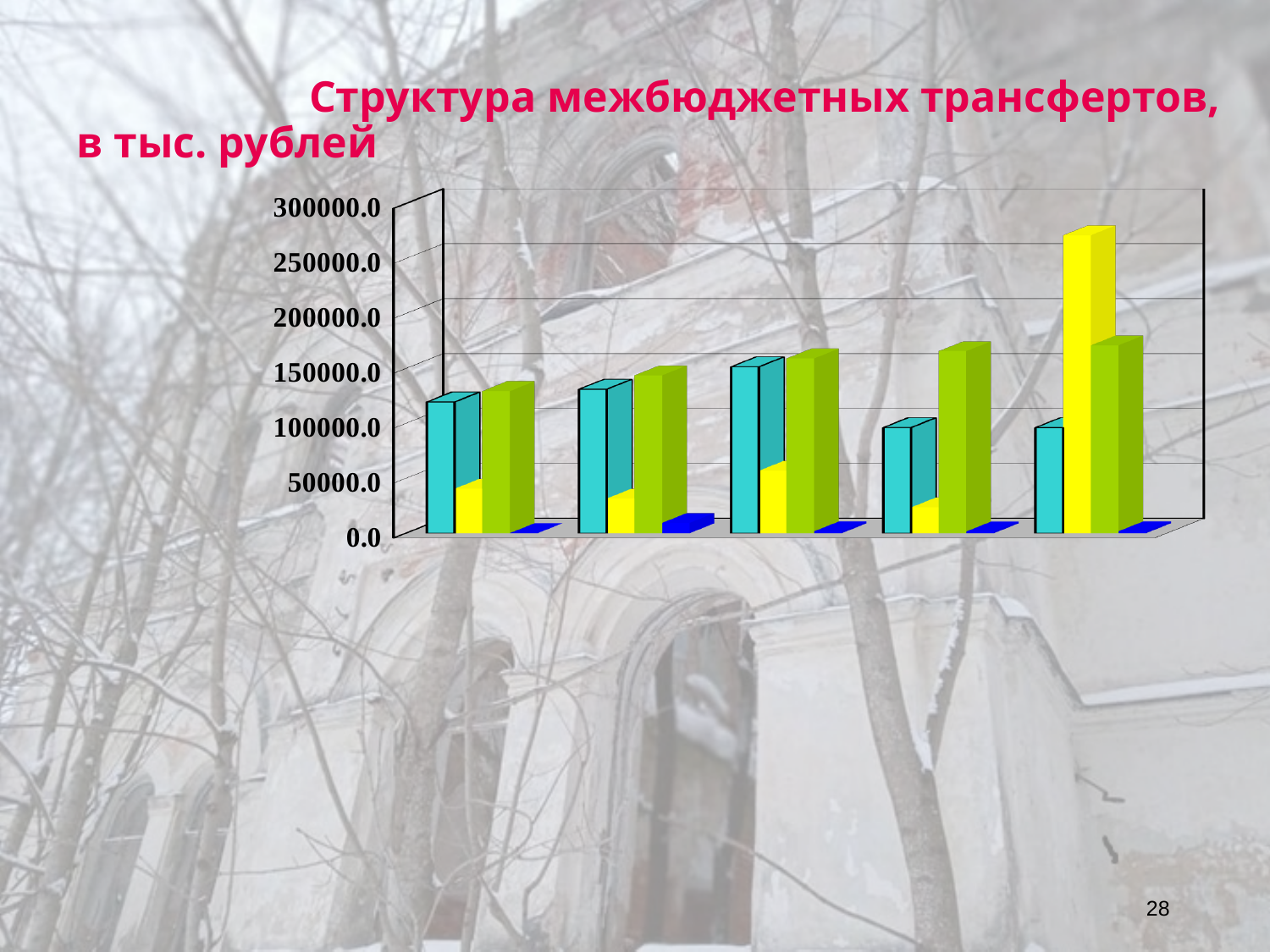
How many bars are there in each group of the chart? 4 Is the value of the cyan bar in the leftmost group greater or less than 100000.0? greater What is the title of the chart on the slide? Структура межбюджетных трансфертов, в тыс. рублей Is the value of the yellow bar in the rightmost group greater or less than 250000.0? greater What kind of chart is shown on the slide? Bar chart What is the highest value shown on the vertical axis of the chart? 300000.0 How many groups of bars are plotted in the chart? 5 Which group of bars contains the tallest bar in the chart? The rightmost (fifth) group Is the value of the green bar in the fourth group from the left greater or less than 150000.0? greater Which colour of bar is the lowest in every group of the chart? Blue In the rightmost group, which bar is taller: the yellow bar or the green bar? The yellow bar